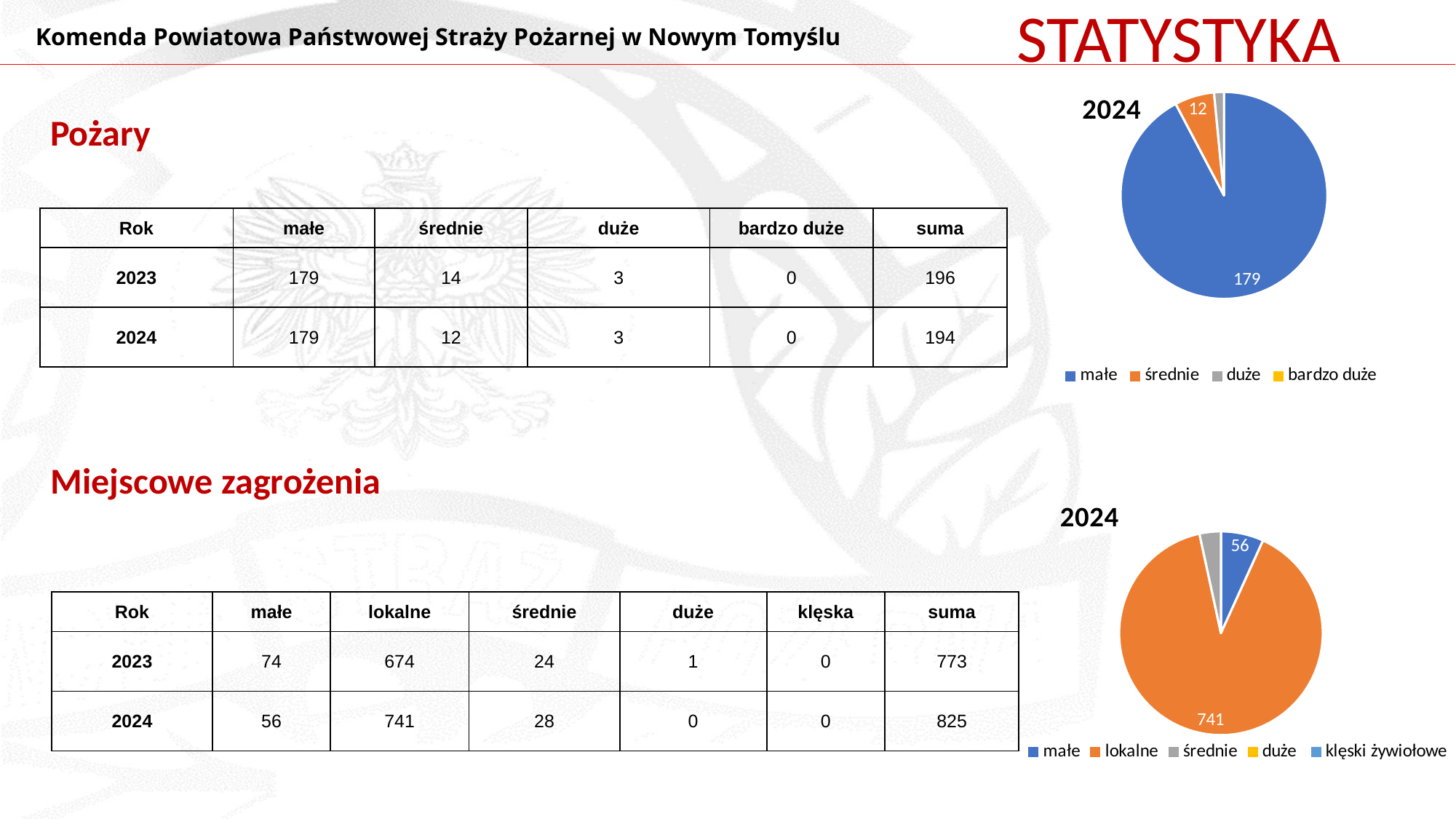
In the bottom pie chart, which is larger: the lokalne slice or the małe slice? lokalne In the top pie chart (next to the Pożary table), what is the difference between the małe and średnie values? 167 In the bottom pie chart (next to the Miejscowe zagrożenia table), what is the difference between the lokalne and małe values? 685 In the top pie chart (next to the Pożary table), what value is shown for the średnie slice? 12 In the top pie chart (next to the Pożary table), which category has the largest slice? małe How many entries does the legend of the bottom pie chart list? 5 In the bottom pie chart (next to the Miejscowe zagrożenia table), which category has the largest slice? lokalne What type of chart is the top chart on the right side of the slide? pie chart In the bottom pie chart (next to the Miejscowe zagrożenia table), what value is shown for the lokalne slice? 741 In the top pie chart (next to the Pożary table), what value is shown for the małe slice? 179 In the bottom pie chart (next to the Miejscowe zagrożenia table), what value is shown for the małe slice? 56 How many entries does the legend of the top pie chart list? 4